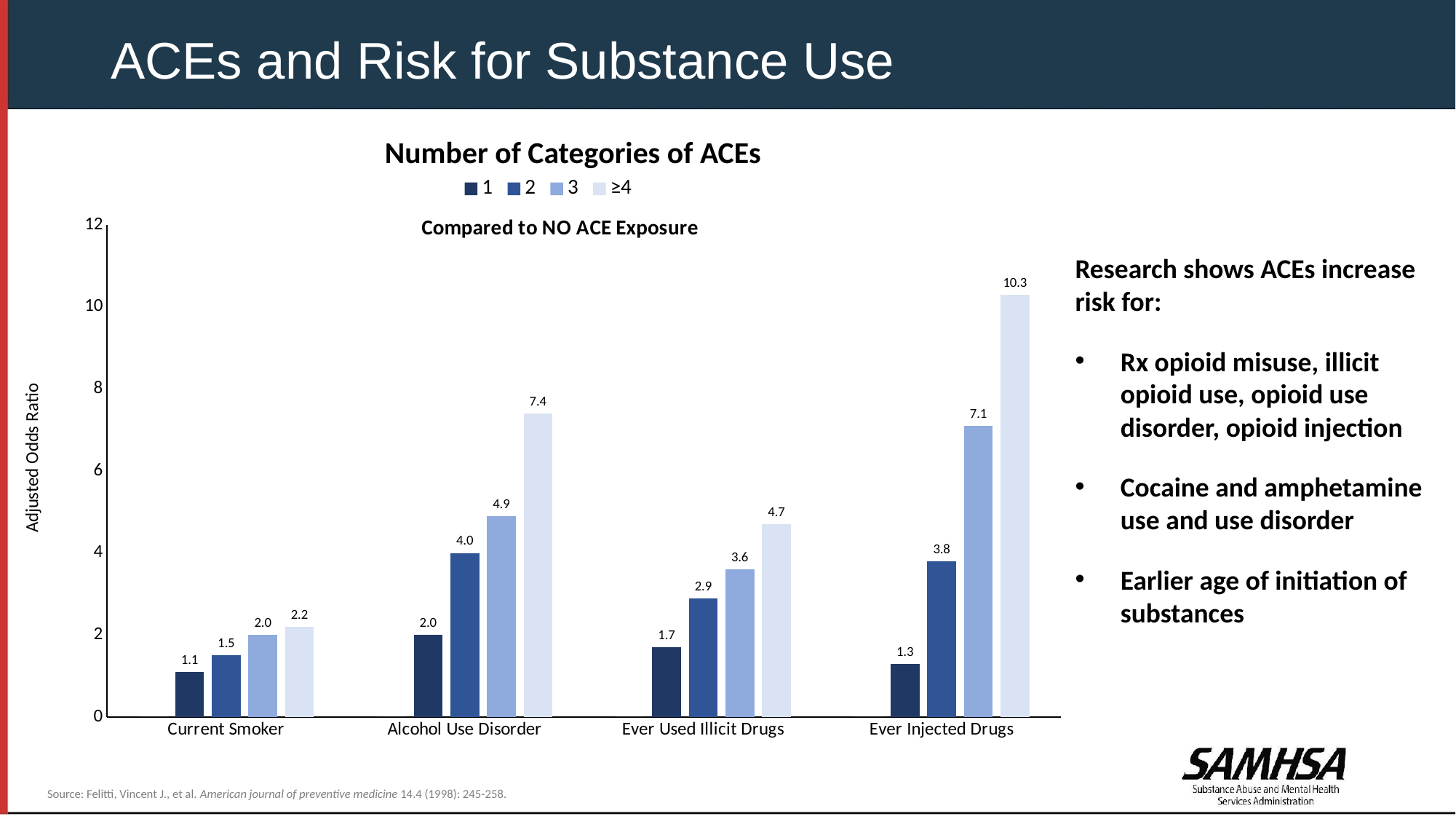
How many series does the legend list? 4 What kind of chart is shown on the slide? Bar chart Which category has the lowest adjusted odds ratio for the 3 ACEs series? Current Smoker What is the adjusted odds ratio for Alcohol Use Disorder with 2 categories of ACEs? 4.0 Which category has the highest adjusted odds ratio for the ≥4 ACEs series? Ever Injected Drugs How many substance use categories are shown on the x axis? 4 Which is larger: the 3 ACEs value for Ever Used Illicit Drugs or the 3 ACEs value for Alcohol Use Disorder? Alcohol Use Disorder Is the ≥4 ACEs value for Ever Injected Drugs greater or less than 10? greater What is the difference between the ≥4 and 1 ACEs values for Alcohol Use Disorder? 5.4 What is the adjusted odds ratio for Ever Injected Drugs with ≥4 categories of ACEs? 10.3 What is the label of the y axis? Adjusted Odds Ratio What is the adjusted odds ratio for Current Smoker with 1 category of ACEs? 1.1